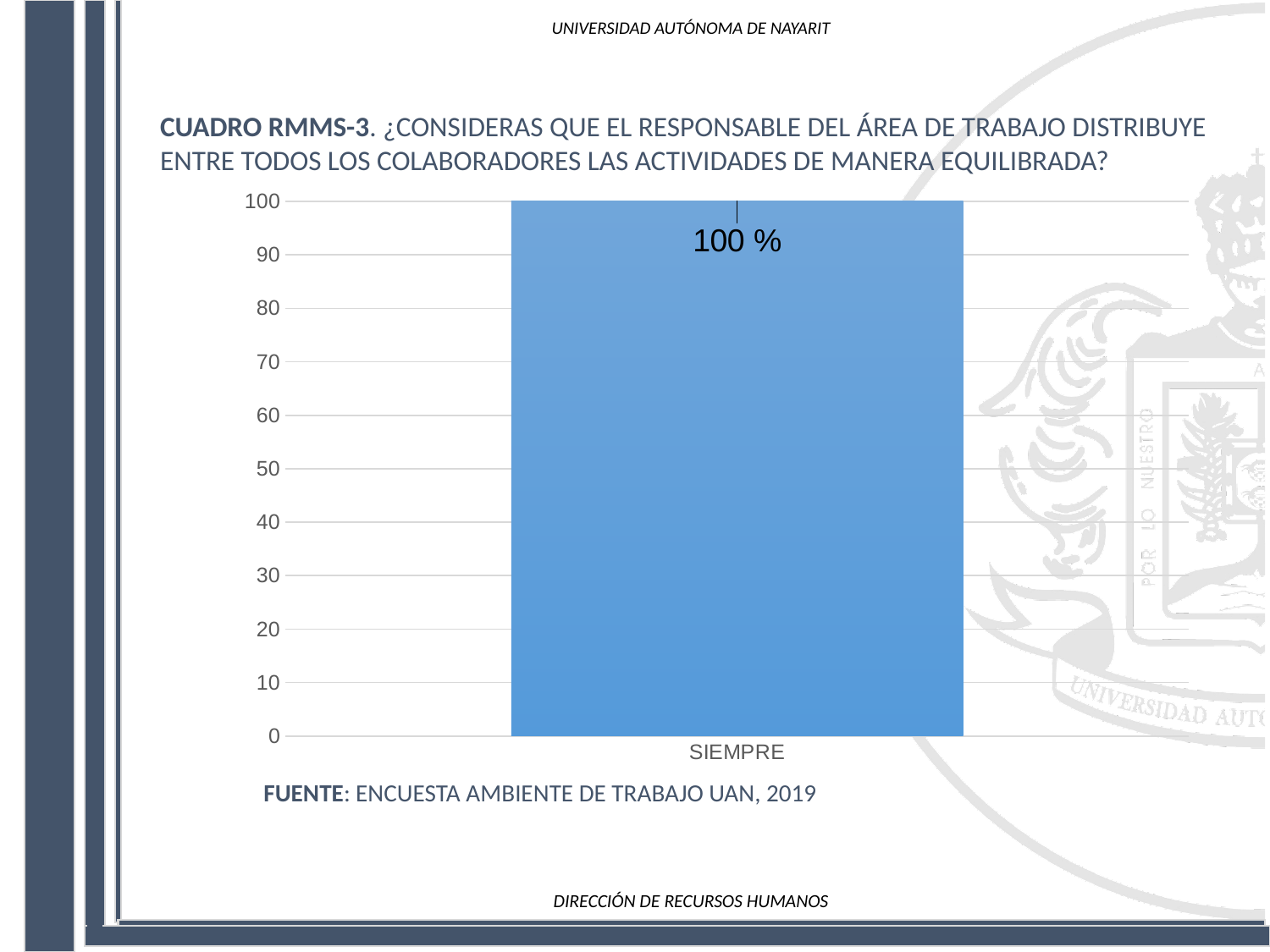
What is the label of the only category on the x axis? SIEMPRE Is the value for SIEMPRE greater or less than 50? greater What is the maximum value shown on the vertical axis? 100 What kind of chart is shown on the slide? bar chart How many categories are plotted on the x axis? 1 What is the value shown for SIEMPRE? 100 %